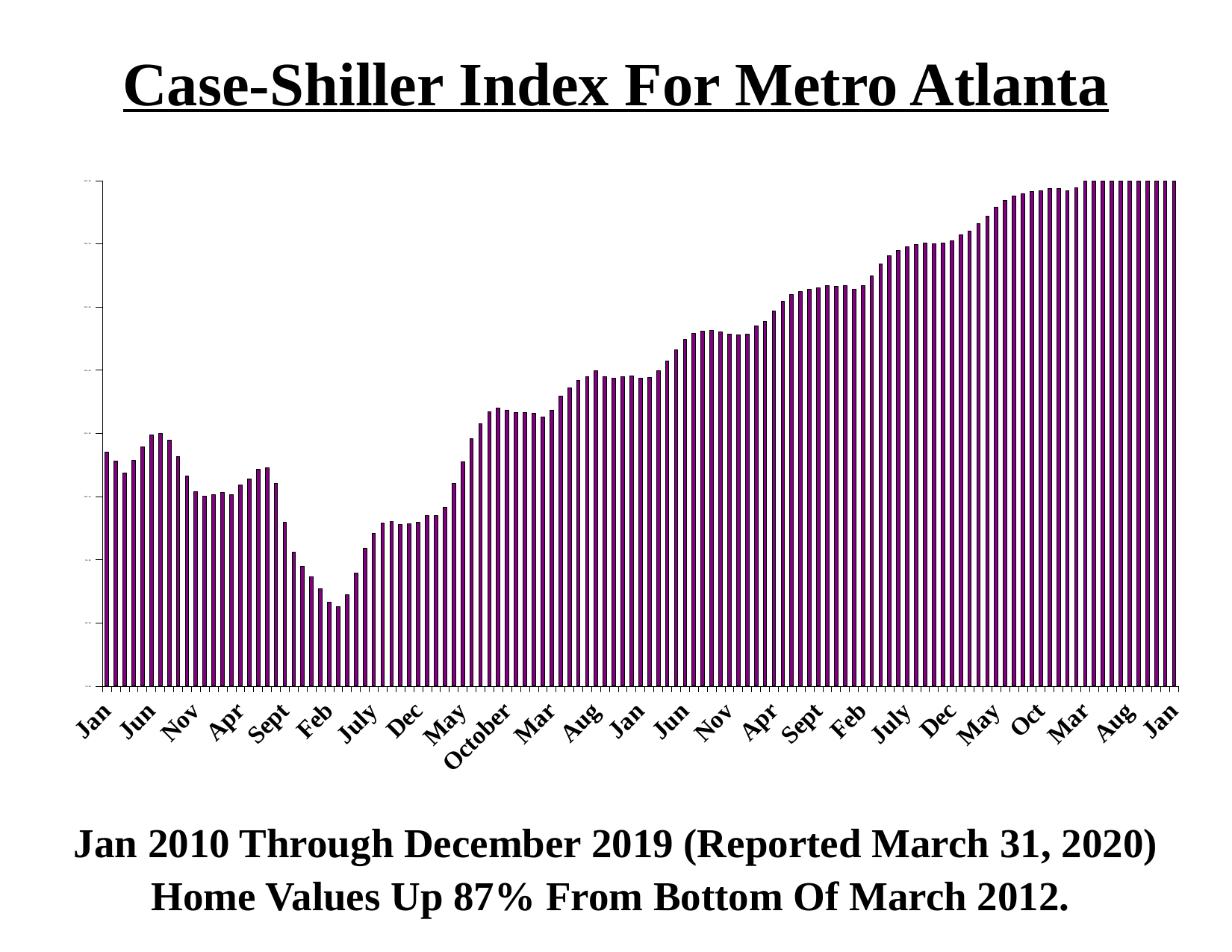
Which is larger: the first bar at the far left (Jan) or the last bar at the far right (Jan)? the last bar at the far right What is the title of the chart on the slide? Case-Shiller Index For Metro Atlanta What kind of chart is shown on the slide? bar chart Between the first bar (Jan, far left) and the bars near the first 'Feb' label, do the values rise or fall? fall According to the text below the chart, by what percentage are home values up from the bottom of March 2012? 87% Are the highest bars in the chart located at the left end or the right end of the x axis? right end Over the whole period from the left of the x axis to the right, do the values of the Case-Shiller Index generally rise or fall? rise